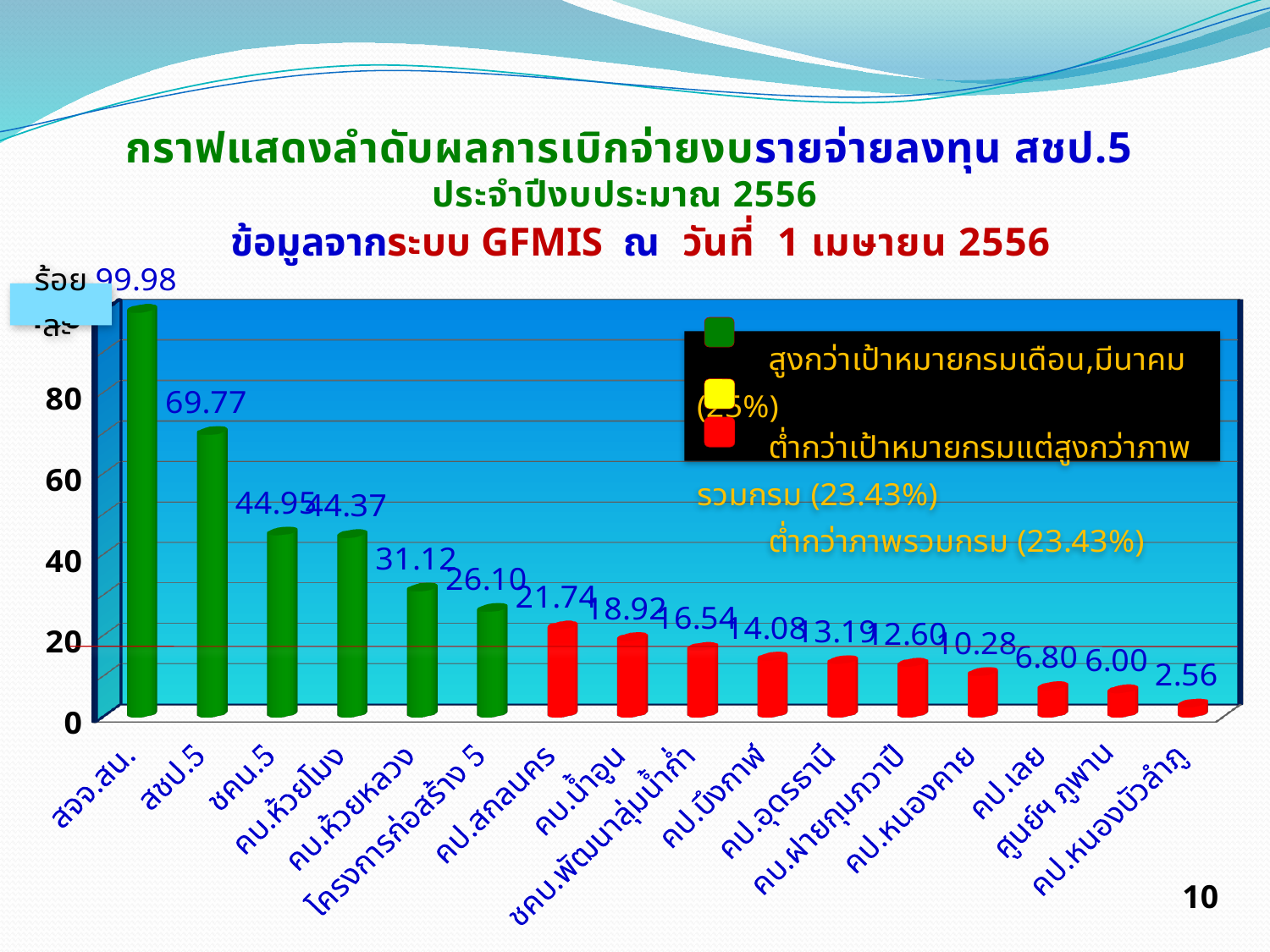
What is the value for สจจ.สน.? 99.98 Which is larger, the value for คป.สกลนคร or the value for คบ.น้ำอูน? คป.สกลนคร How many categories are shown on the x axis? 16 What kind of chart is shown on the slide? bar chart What is the difference between the values for สจจ.สน. and สชป.5? 30.21 Is the value for สชป.5 greater or less than 60? greater What is the value for คป.หนองคาย? 10.28 What is the value for คบ.ห้วยหลวง? 31.12 Which category has the highest value? สจจ.สน. Which category has the lowest value? คป.หนองบัวลำภู Do the values rise or fall from left to right along the x axis? fall How many bars are coloured green? 6